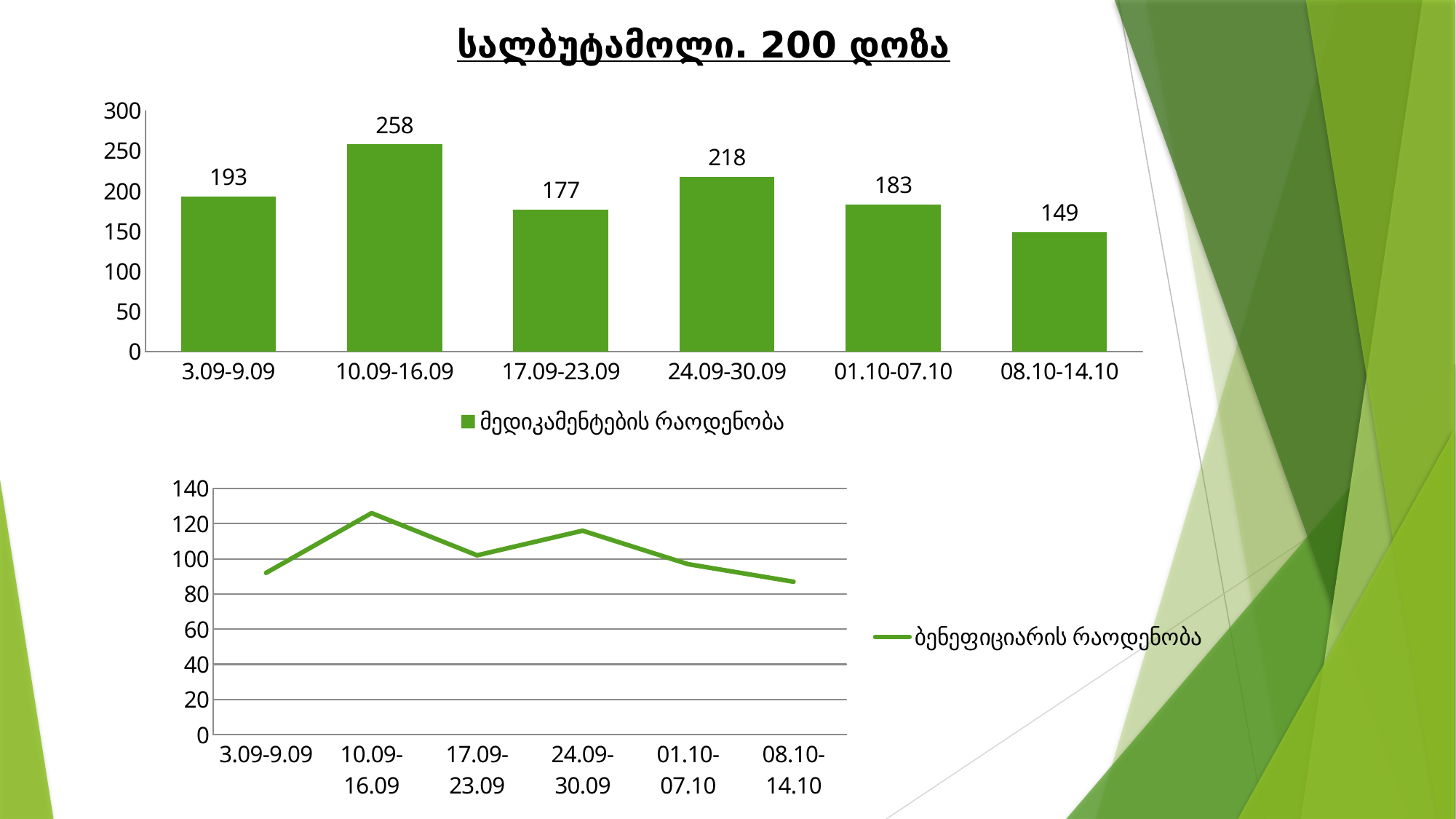
In the bottom line chart, is the value for 08.10-14.10 greater or less than 100? less In the top bar chart, which period has the lowest value? 08.10-14.10 In the top bar chart, which is larger: the value for 24.09-30.09 or the value for 01.10-07.10? 24.09-30.09 In the top bar chart, what is the value for 10.09-16.09? 258 How many periods are shown on the x axis of the top bar chart? 6 In the bottom line chart, does the line rise or fall from 24.09-30.09 to 08.10-14.10? fall In the top bar chart, what is the value for 08.10-14.10? 149 What is the legend entry of the bottom line chart? ბენეფიციარის რაოდენობა What kind of chart is the bottom chart on the slide? line chart In the bottom line chart, is the value for 10.09-16.09 greater or less than 120? greater In the top bar chart, which period has the highest value? 10.09-16.09 In the top bar chart, what is the difference between the values for 10.09-16.09 and 17.09-23.09? 81